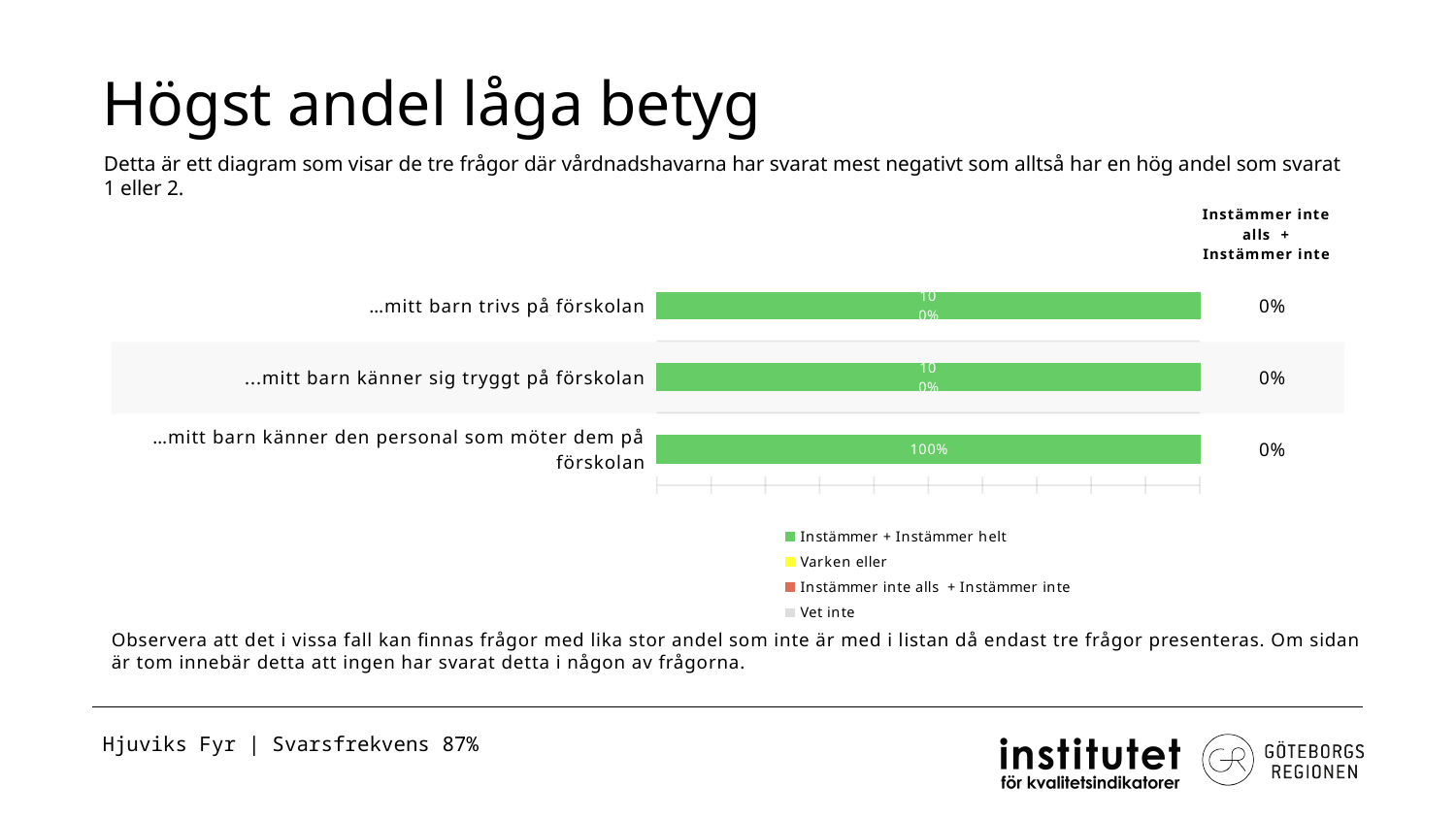
What kind of chart is shown on the slide? bar chart What is the 'Instämmer inte alls + Instämmer inte' value shown for '…mitt barn trivs på förskolan'? 0% Which legend entry is represented by the yellow colour? Varken eller Which legend entry is represented by the green colour? Instämmer + Instämmer helt Is the green segment for '…mitt barn känner sig tryggt på förskolan' greater or less than 50%? greater How many categories (questions) are shown in the chart? 3 Is the green segment for '…mitt barn trivs på förskolan' greater or less than 50%? greater What is the 'Instämmer inte alls + Instämmer inte' value shown for '…mitt barn känner den personal som möter dem på förskolan'? 0% What is the 'Instämmer inte alls + Instämmer inte' value shown for '…mitt barn känner sig tryggt på förskolan'? 0% What is the value of the green 'Instämmer + Instämmer helt' segment for '…mitt barn känner den personal som möter dem på förskolan'? 100% How many series does the legend list? 4 What is the last legend entry listed below the chart? Vet inte